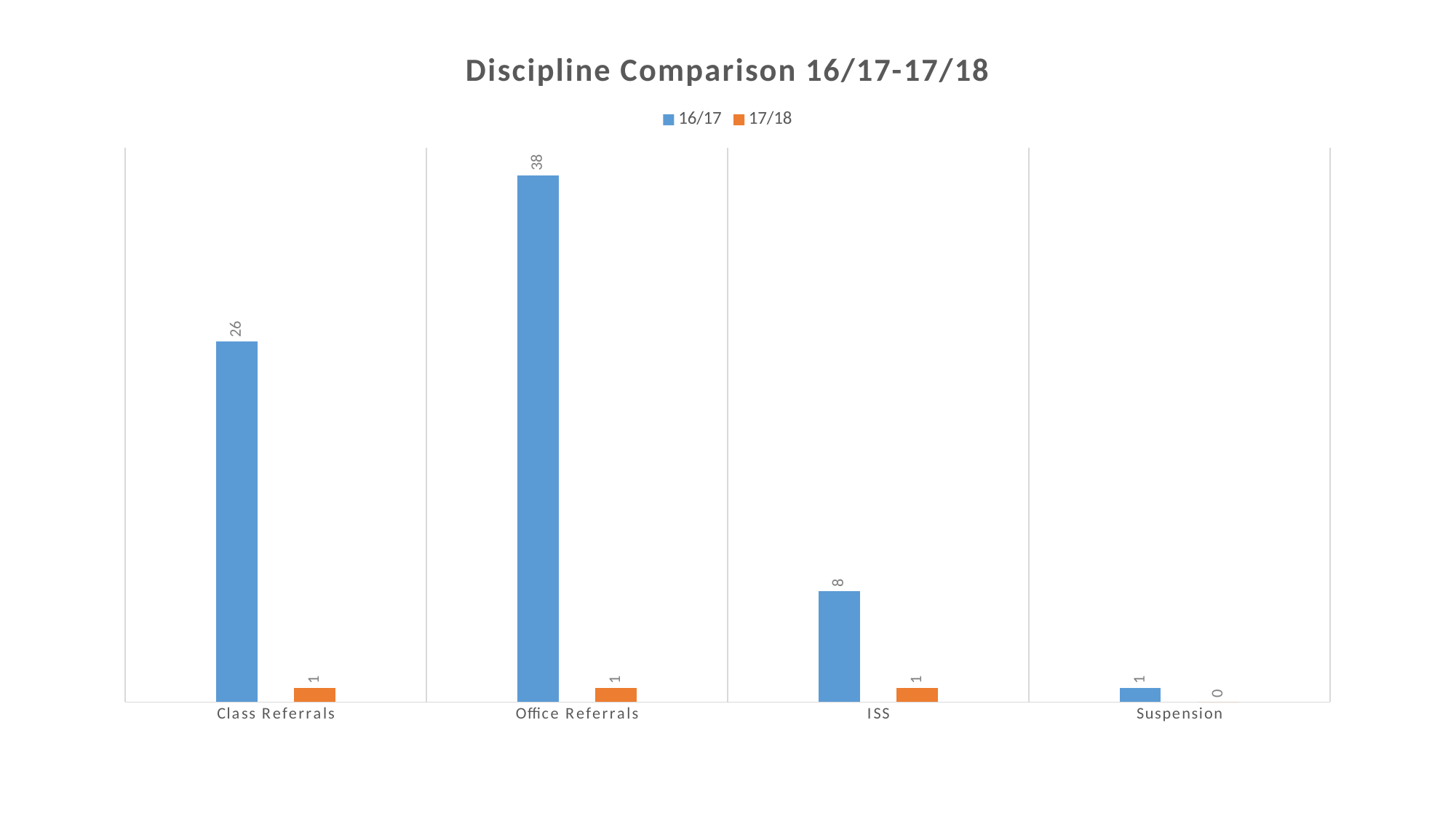
Which category has the lowest 16/17 value? Suspension How many series does the legend list? 2 What is the 17/18 value for Suspension? 0 How many categories are shown on the x axis? 4 Which is larger, the 16/17 value for Class Referrals or the 16/17 value for ISS? Class Referrals What is the 16/17 value for ISS? 8 What is the 16/17 value for Class Referrals? 26 Which category has the highest 16/17 value? Office Referrals What is the difference between the 16/17 and 17/18 values for Office Referrals? 37 What kind of chart is shown on the slide? Bar chart What is the 16/17 value for Office Referrals? 38 What is the difference between the 16/17 values for Office Referrals and Class Referrals? 12